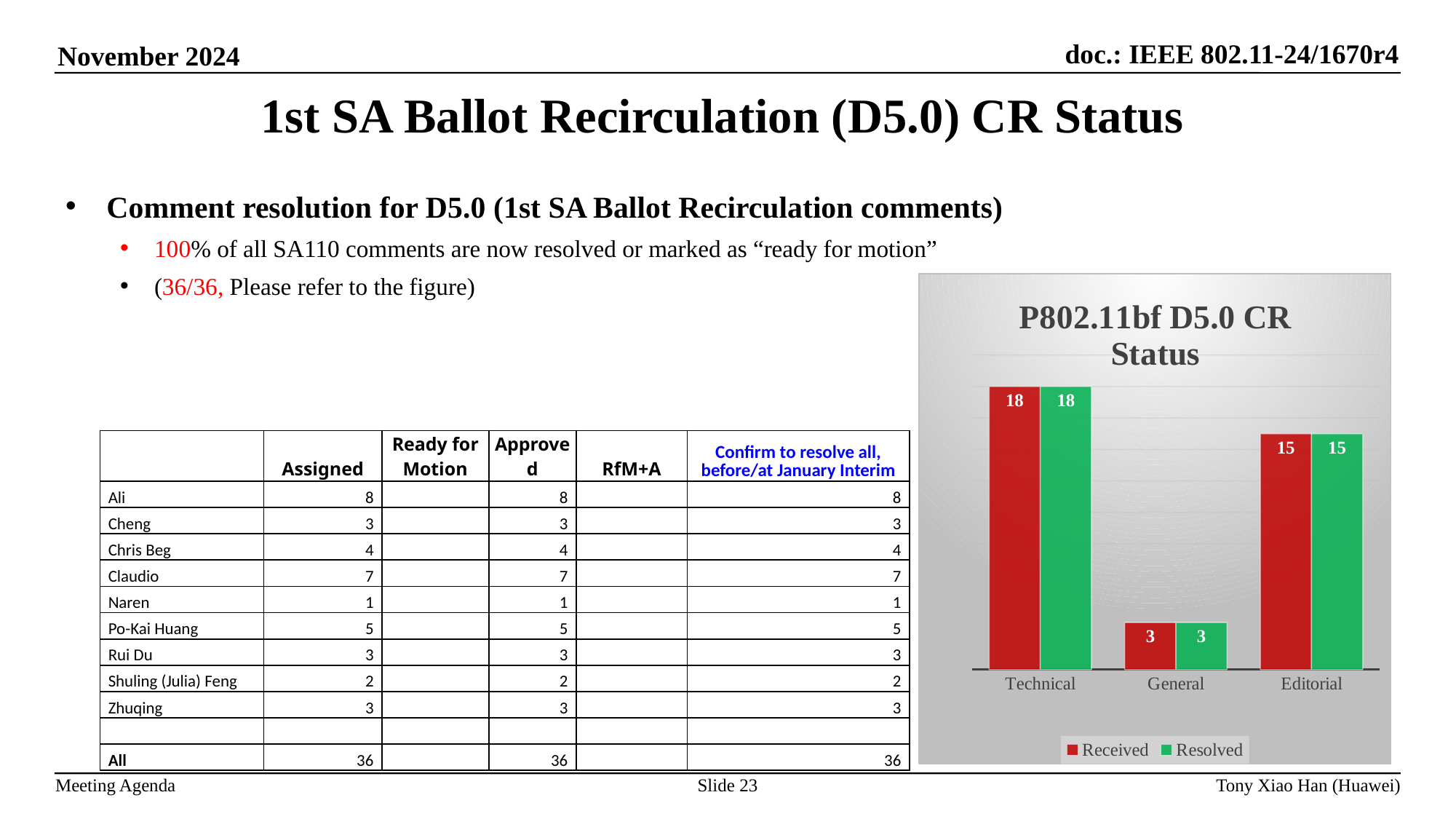
What kind of chart is the P802.11bf D5.0 CR Status chart? Bar chart Which category has the lowest Resolved value in the P802.11bf D5.0 CR Status chart? General What is the Resolved value for General in the P802.11bf D5.0 CR Status chart? 3 How many series does the legend of the P802.11bf D5.0 CR Status chart list? 2 Which category has the highest Received value in the P802.11bf D5.0 CR Status chart? Technical What is the difference between the Resolved values for Editorial and General in the P802.11bf D5.0 CR Status chart? 12 What is the difference between the Received values for Technical and Editorial in the P802.11bf D5.0 CR Status chart? 3 In the P802.11bf D5.0 CR Status chart, is the Received value larger for General or for Editorial? Editorial What is the Received value for Technical in the P802.11bf D5.0 CR Status chart? 18 What is the Received value for Editorial in the P802.11bf D5.0 CR Status chart? 15 Which colour represents the Resolved series in the P802.11bf D5.0 CR Status chart? Green How many categories are shown on the x axis of the P802.11bf D5.0 CR Status chart? 3